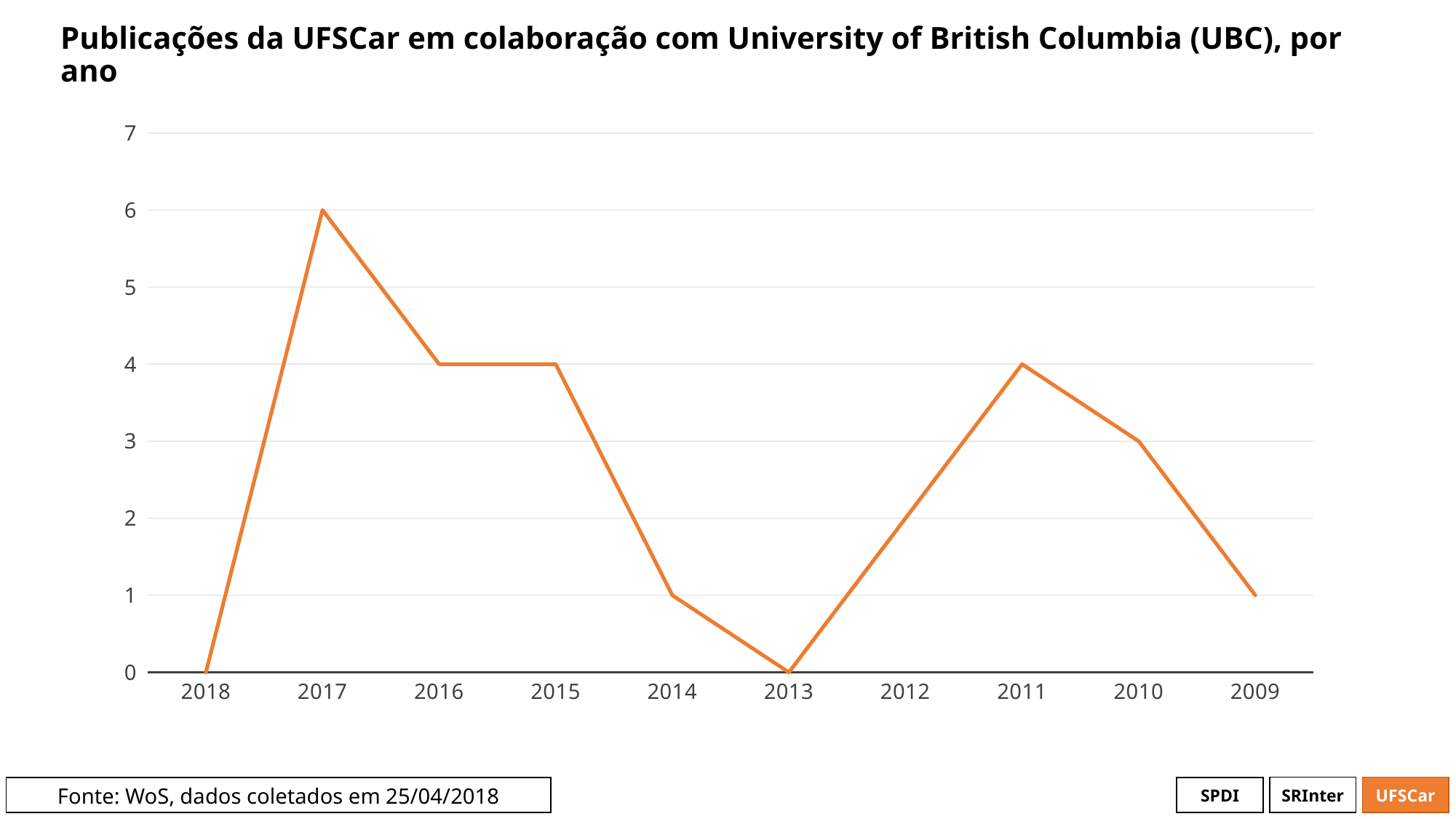
What is the value for 2010? 3 Which years have a value of 0? 2018 and 2013 What is the value for 2014? 1 Which year has the highest number of publications? 2017 Is the value for 2009 greater or less than 3? less How many publications are shown for 2017? 6 Do the values rise or fall from 2013 to 2011 along the x axis? rise What is the title of the chart? Publicações da UFSCar em colaboração com University of British Columbia (UBC), por ano How many years are plotted on the x axis? 10 Which year has the larger value, 2011 or 2010? 2011 What kind of chart is shown on the slide? line chart What is the difference between the values for 2017 and 2016? 2